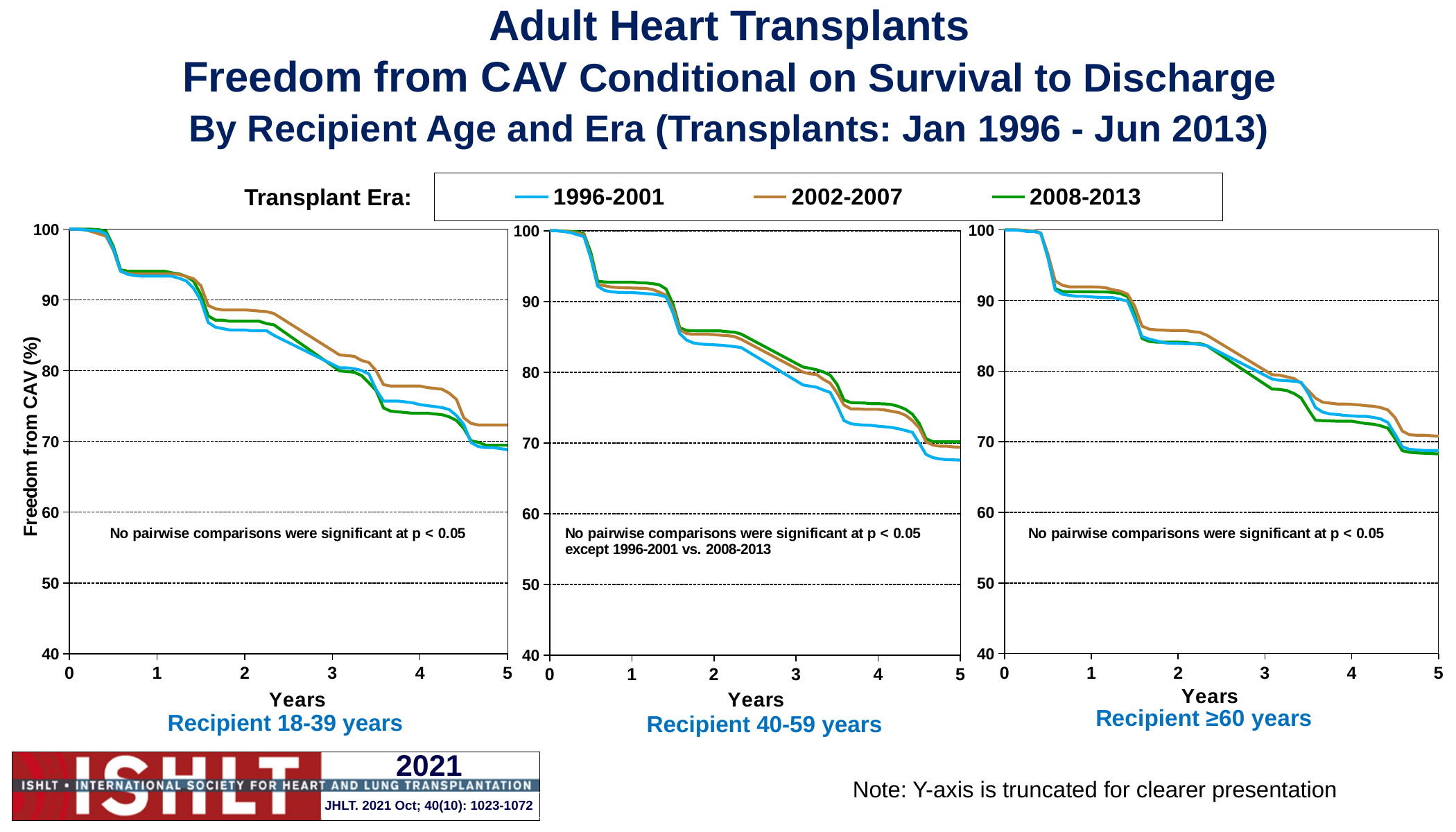
In the 'Recipient 40-59 years' chart, is the value for the 1996-2001 era at year 5 greater or less than 70? less In the 'Recipient ≥60 years' chart, is the value for the 2008-2013 era at year 5 greater or less than 70? less In the 'Recipient 18-39 years' chart, is the value for the 2002-2007 era at year 5 greater or less than 70? greater In the 'Recipient 40-59 years' chart, which era has the lower freedom from CAV at year 5: 1996-2001 or 2008-2013? 1996-2001 In the 'Recipient 40-59 years' chart, do the curves rise or fall as years increase? fall Which recipient age group chart notes an exception to 'No pairwise comparisons were significant at p < 0.05'? Recipient 40-59 years In the 'Recipient 18-39 years' chart, which era has the higher freedom from CAV at year 5: 2002-2007 or 1996-2001? 2002-2007 In the 'Recipient ≥60 years' chart, which era has the higher freedom from CAV at year 4: 2002-2007 or 2008-2013? 2002-2007 What kind of chart is used in the 'Recipient 18-39 years' panel? line chart How many transplant eras does the legend list? 3 What is the label of the y-axis on the left chart? Freedom from CAV (%)